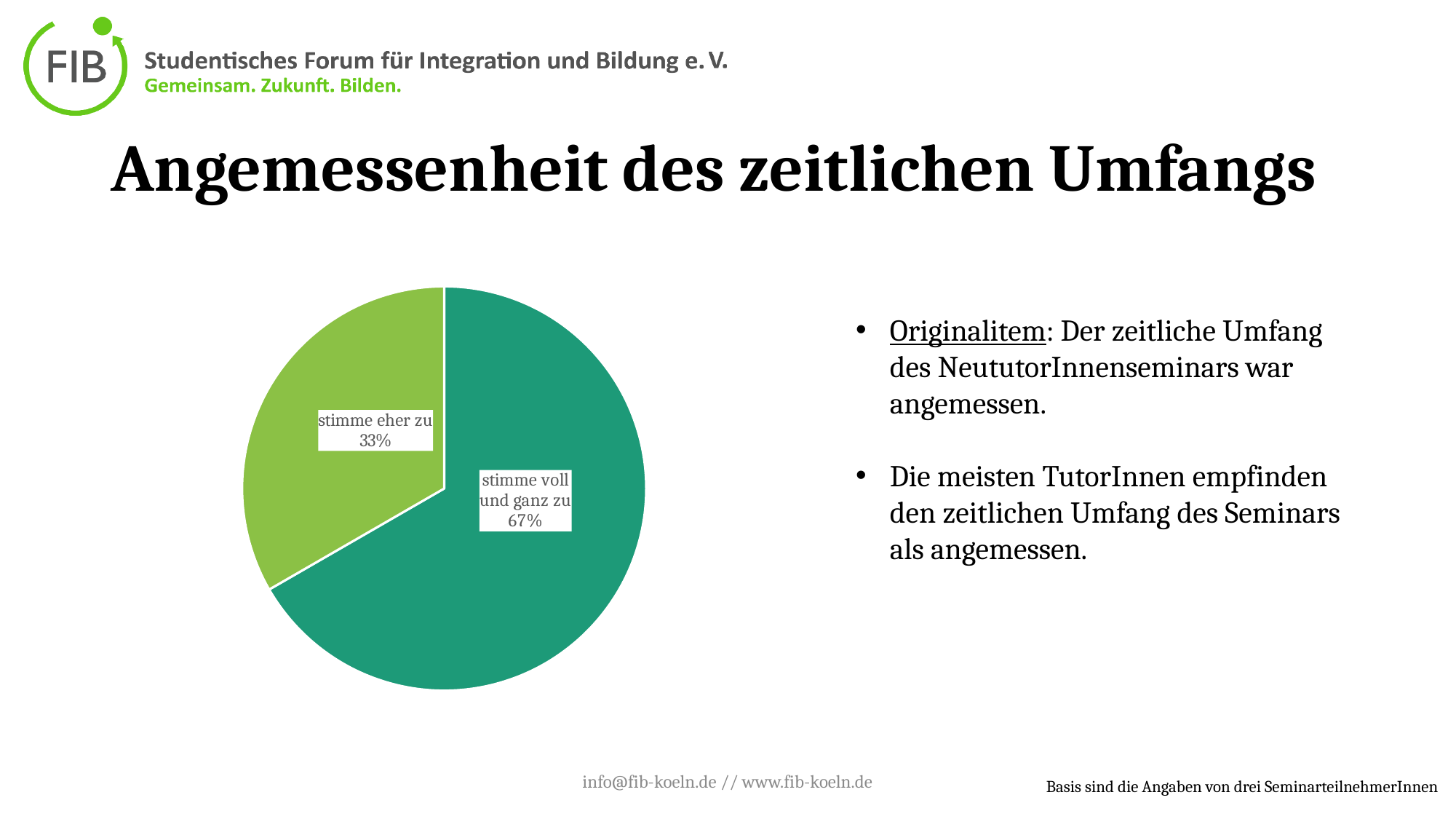
What is the difference in percentage points between the "stimme voll und ganz zu" slice and the "stimme eher zu" slice? 34 percentage points What colour is the "stimme eher zu" slice? light green What share of the pie is labelled "stimme eher zu"? 33% Which is larger: the "stimme eher zu" slice or the "stimme voll und ganz zu" slice? stimme voll und ganz zu What kind of chart is shown on the slide? pie chart What is the title of the slide containing the pie chart? Angemessenheit des zeitlichen Umfangs Which slice of the pie chart is the smallest? stimme eher zu How many slices does the pie chart have? 2 Which slice of the pie chart is the largest? stimme voll und ganz zu What is the combined share of the two slices in the pie chart? 100% What share of the pie is labelled "stimme voll und ganz zu"? 67% Is the share for "stimme voll und ganz zu" greater or less than 50%? greater